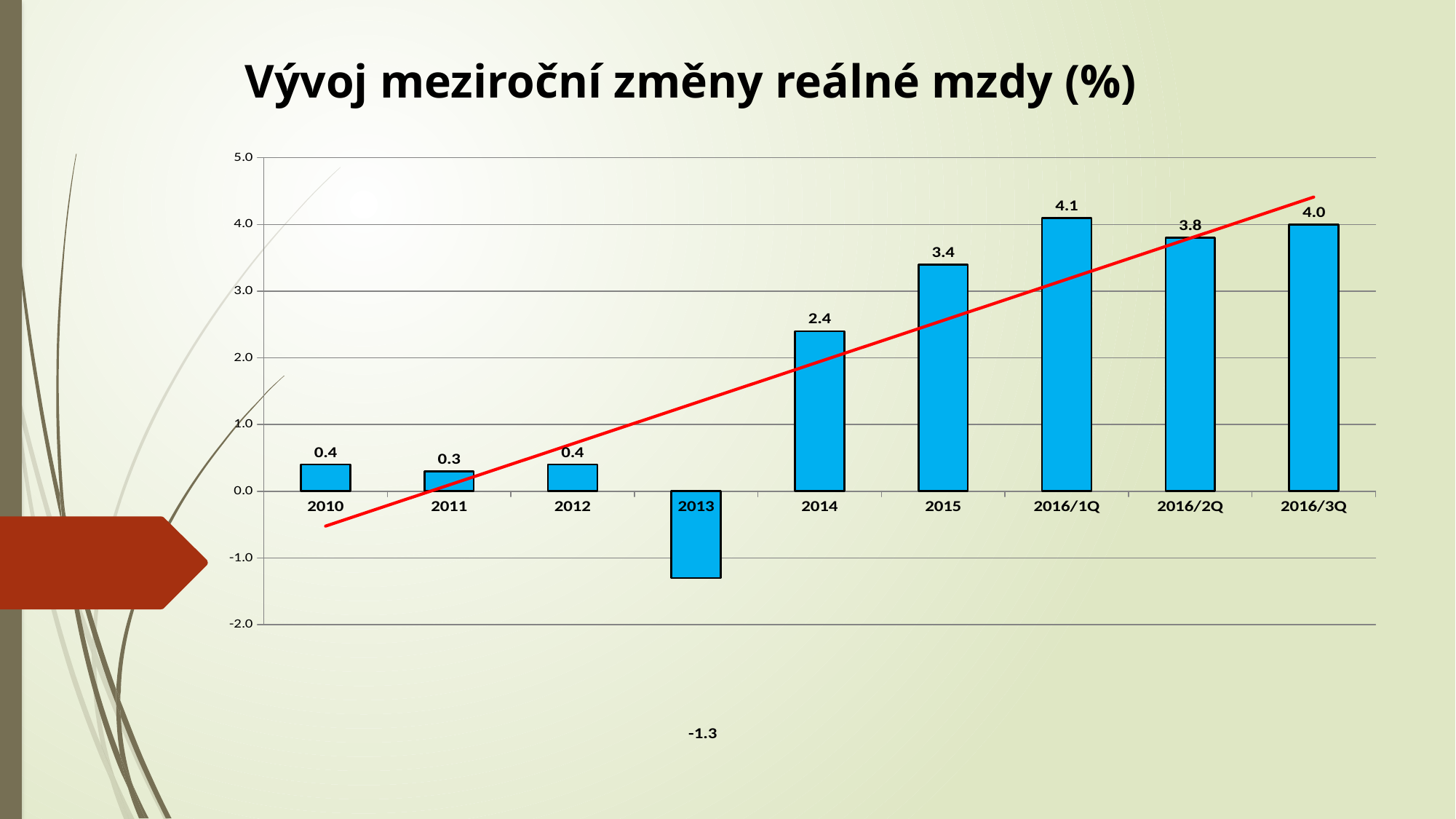
Which category has the lowest value? 2013 What is the title of the chart? Vývoj meziroční změny reálné mzdy (%) Do the values generally rise or fall from 2013 to 2016/1Q? rise How many categories are shown on the x axis? 9 What kind of chart is this? bar chart What is the value for 2013? -1.3 What is the value for 2014? 2.4 Which is larger, the value for 2016/2Q or the value for 2016/3Q? 2016/3Q What is the difference between the values for 2016/1Q and 2015? 0.7 What is the value for 2016/1Q? 4.1 Which category has the highest value? 2016/1Q Is the value for 2015 greater or less than 3.0? greater